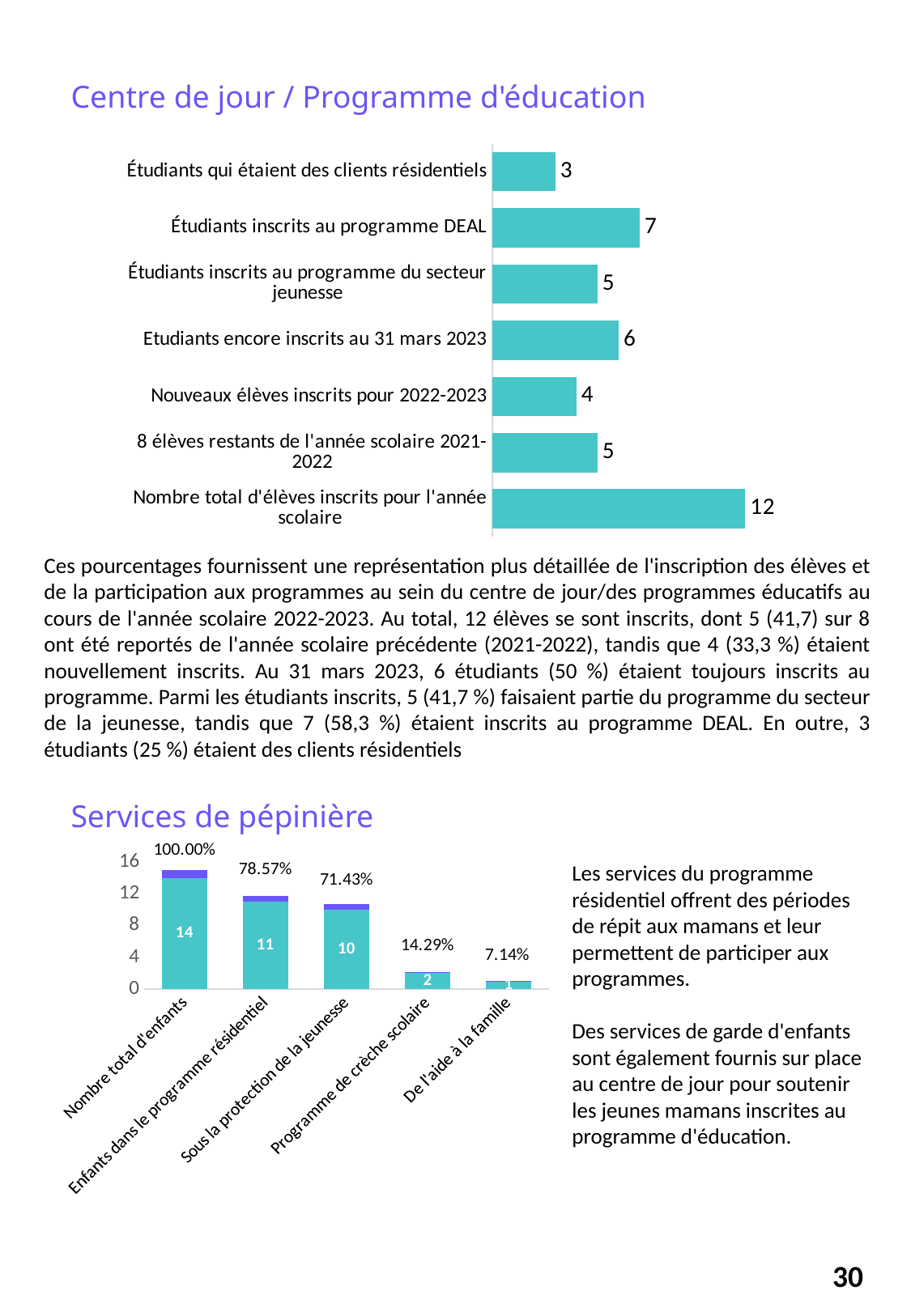
How many categories are shown in the 'Services de pépinière' chart? 5 In the 'Centre de jour / Programme d'éducation' chart, what is the value for 'Étudiants qui étaient des clients résidentiels'? 3 How many categories are shown in the 'Centre de jour / Programme d'éducation' chart? 7 In the 'Services de pépinière' chart, what is the value labelled on the bar for 'Enfants dans le programme résidentiel'? 11 In the 'Centre de jour / Programme d'éducation' chart, which category has the highest value? Nombre total d'élèves inscrits pour l'année scolaire What type of chart is the 'Centre de jour / Programme d'éducation' chart? Bar chart In the 'Services de pépinière' chart, which category has the lowest value? De l'aide à la famille In the 'Centre de jour / Programme d'éducation' chart, which category has the lowest value? Étudiants qui étaient des clients résidentiels In the 'Centre de jour / Programme d'éducation' chart, what is the difference between 'Nombre total d'élèves inscrits pour l'année scolaire' and 'Etudiants encore inscrits au 31 mars 2023'? 6 In the 'Centre de jour / Programme d'éducation' chart, which is larger: 'Étudiants inscrits au programme DEAL' or 'Nouveaux élèves inscrits pour 2022-2023'? Étudiants inscrits au programme DEAL In the 'Services de pépinière' chart, what percentage is shown above 'Sous la protection de la jeunesse'? 71.43% In the 'Centre de jour / Programme d'éducation' chart, what is the value for 'Étudiants inscrits au programme DEAL'? 7